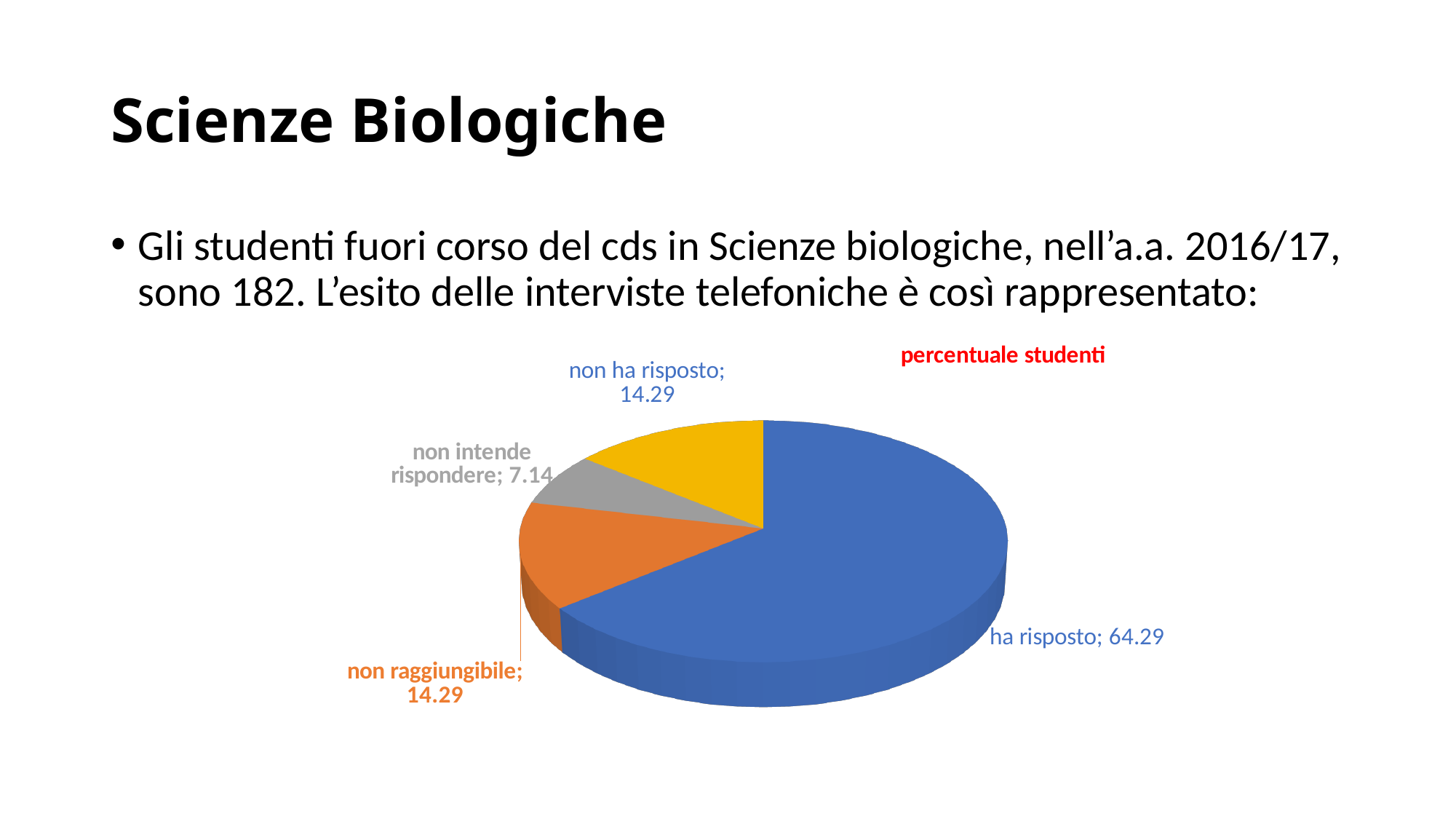
How many slices does the pie chart have? 4 Which category has the largest slice of the pie? ha risposto What is the difference between the values for "non ha risposto" and "non intende rispondere"? 7.15 Which is larger, the value for "non raggiungibile" or the value for "non intende rispondere"? non raggiungibile What is the title of the chart? percentuale studenti What is the value for "non raggiungibile"? 14.29 What is the value for "ha risposto"? 64.29 Which category has the smallest slice of the pie? non intende rispondere What is the difference between the values for "ha risposto" and "non raggiungibile"? 50 What is the value for "non intende rispondere"? 7.14 What is the value for "non ha risposto"? 14.29 What kind of chart is shown on the slide? pie chart